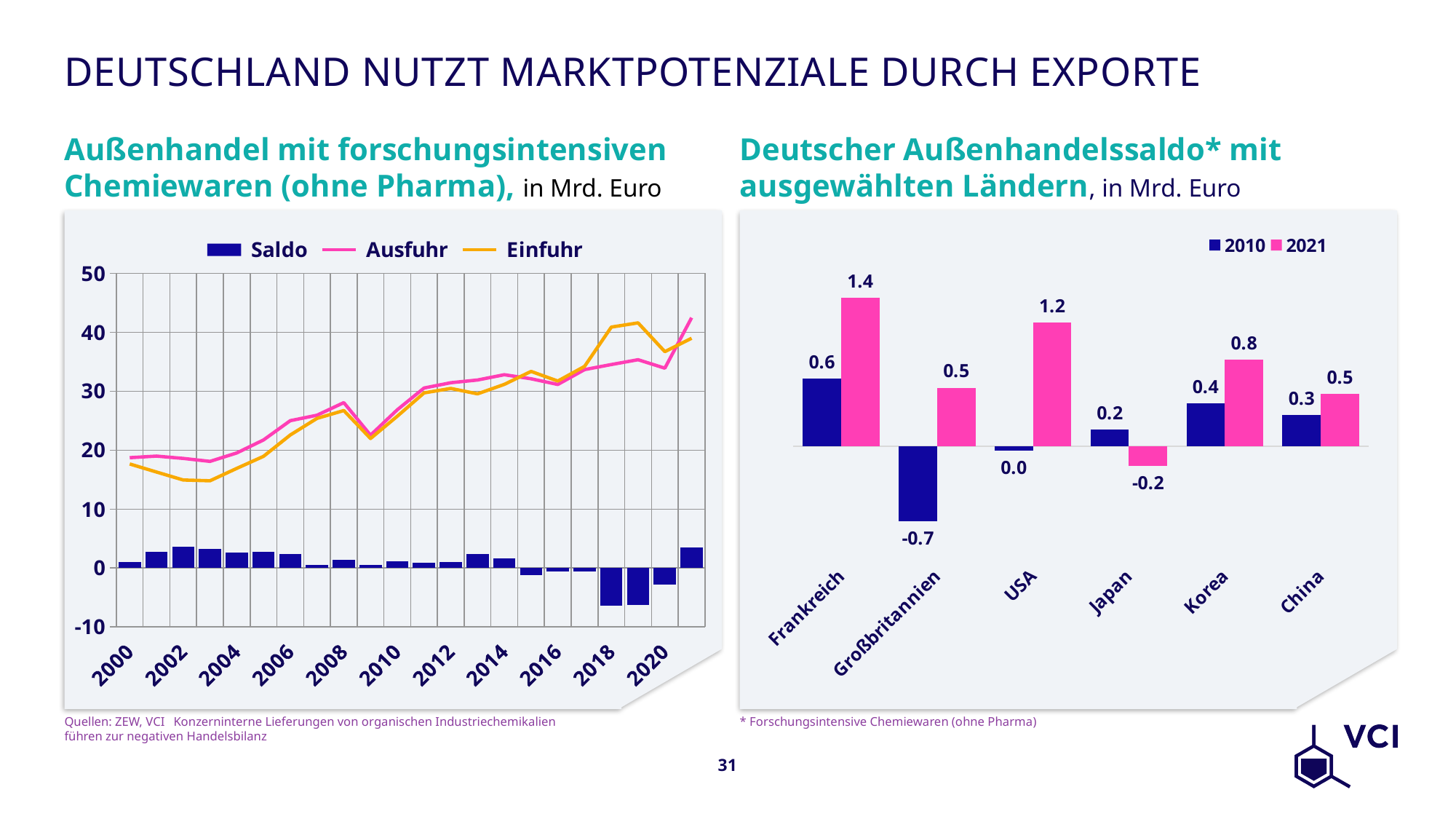
In the chart 'Deutscher Außenhandelssaldo mit ausgewählten Ländern', what is the value for Großbritannien in 2010? -0.7 What type of chart is 'Deutscher Außenhandelssaldo mit ausgewählten Ländern'? bar chart In the chart 'Deutscher Außenhandelssaldo mit ausgewählten Ländern', which country has the lowest value for 2010? Großbritannien In the chart 'Deutscher Außenhandelssaldo mit ausgewählten Ländern', which is larger for Japan: the 2010 value or the 2021 value? 2010 In the chart 'Deutscher Außenhandelssaldo mit ausgewählten Ländern', what is the value for USA in 2010? 0.0 In the chart 'Außenhandel mit forschungsintensiven Chemiewaren (ohne Pharma)', is the Ausfuhr value for 2021 greater or less than 40? greater How many countries are shown in the chart 'Deutscher Außenhandelssaldo mit ausgewählten Ländern'? 6 In the chart 'Deutscher Außenhandelssaldo mit ausgewählten Ländern', what is the difference between the 2021 and 2010 values for Korea? 0.4 How many series does the legend of the chart 'Außenhandel mit forschungsintensiven Chemiewaren (ohne Pharma)' list? 3 In the chart 'Deutscher Außenhandelssaldo mit ausgewählten Ländern', which country has the highest value for 2021? Frankreich In the chart 'Außenhandel mit forschungsintensiven Chemiewaren (ohne Pharma)', is the Einfuhr value for 2004 greater or less than 20? less In the chart 'Deutscher Außenhandelssaldo mit ausgewählten Ländern', what is the value for Frankreich in 2021? 1.4